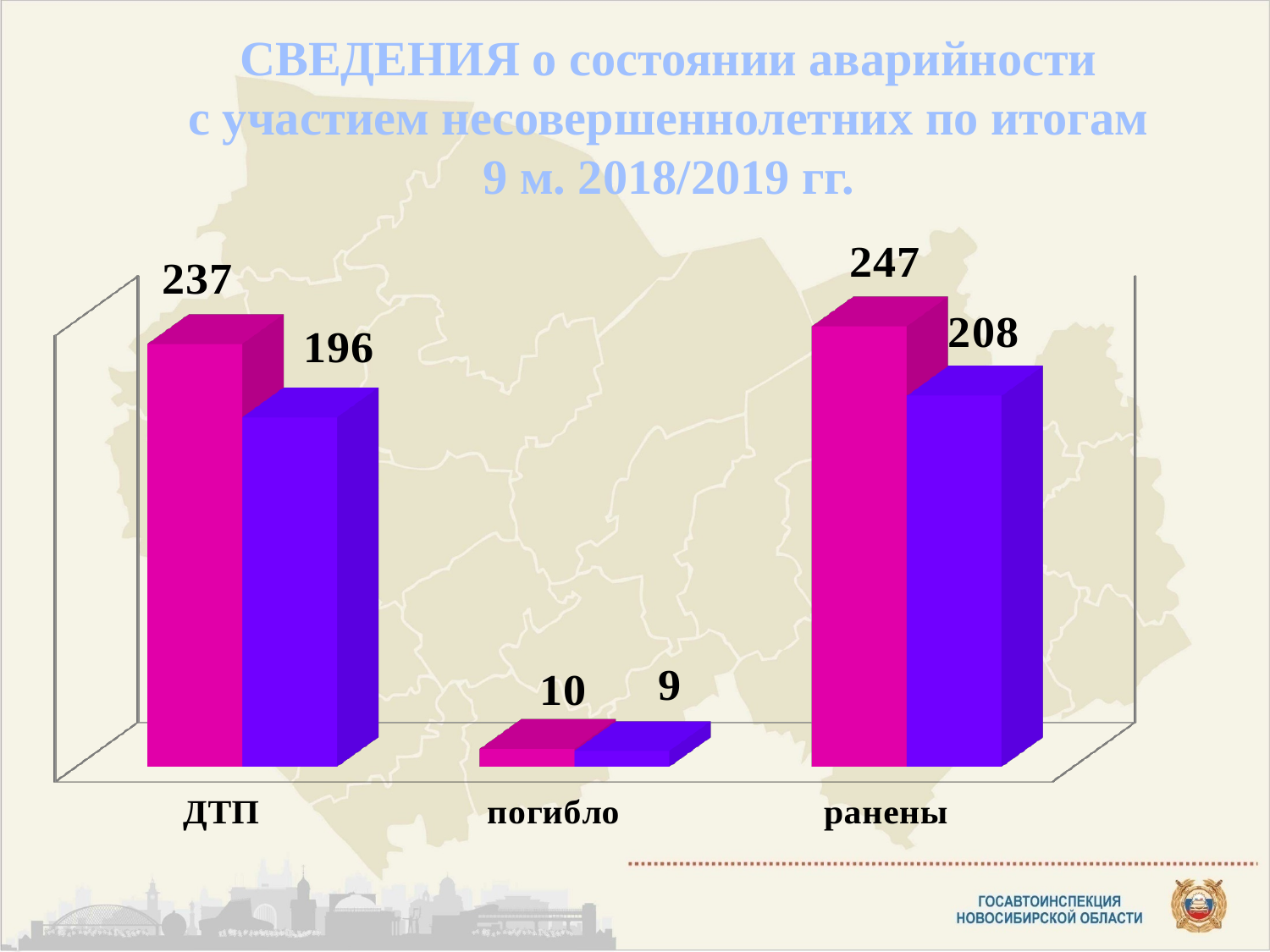
What are the category labels on the x axis? ДТП, погибло, ранены How many categories are shown on the x axis? 3 What kind of chart is shown on the slide? bar chart What is the difference between the magenta and blue bars for ранены? 39 Which category has the highest magenta bar? ранены What is the value of the blue bar for ранены? 208 Which category has the lowest blue bar? погибло What is the value of the magenta bar for ДТП? 237 Which is larger for погибло, the magenta bar or the blue bar? the magenta bar What is the difference between the magenta and blue bars for ДТП? 41 What is the value of the magenta bar for погибло? 10 What is the value of the blue bar for ДТП? 196